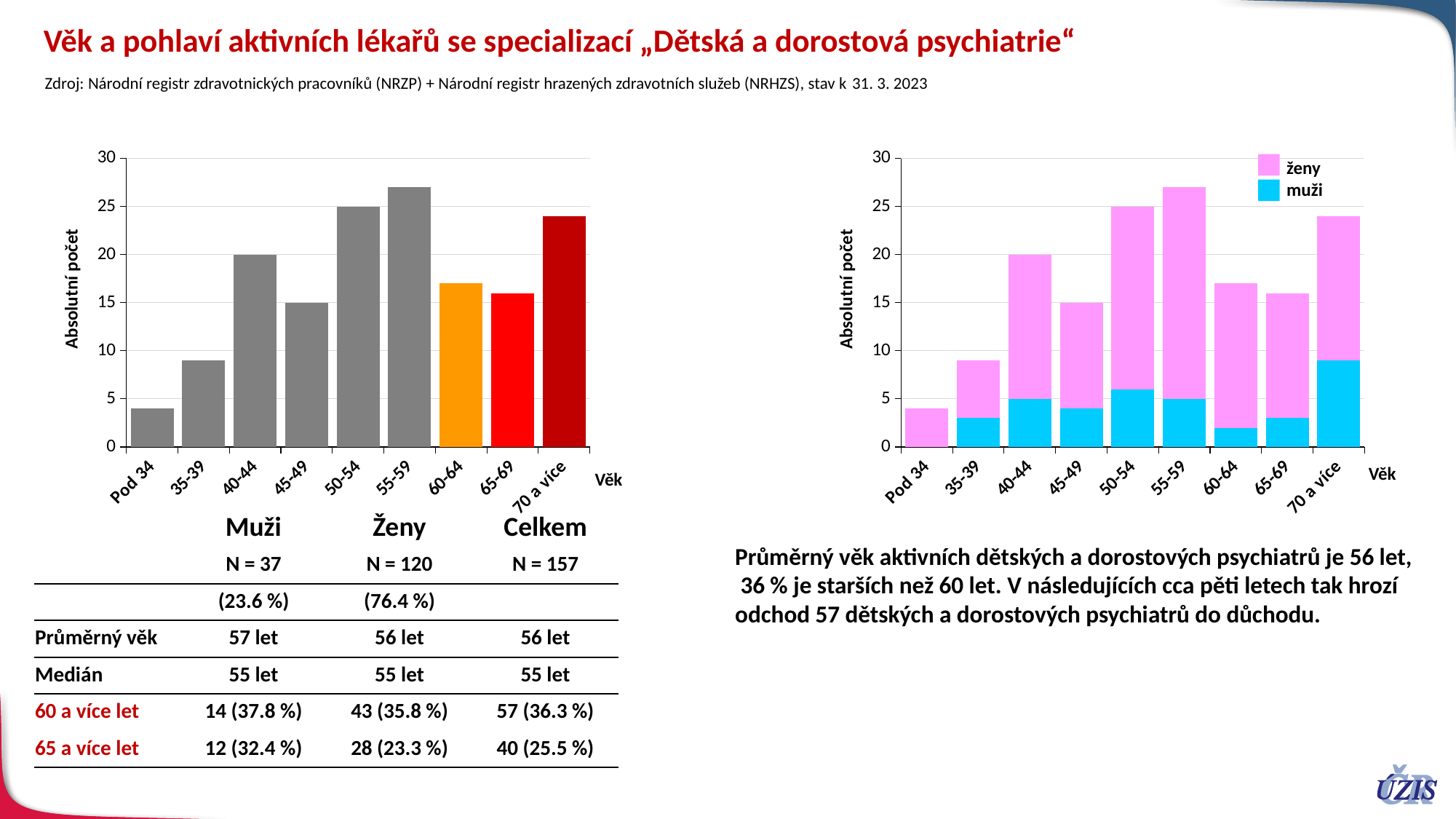
What are the two legend entries in the right chart? ženy, muži In the left chart, what is the absolute count for the 50-54 age group? 25 In the left chart, which age group has a larger value, 40-44 or 45-49? 40-44 In the left chart, is the value for the 55-59 age group greater or less than 25? greater In the right chart, is the muži value for the 70 a více age group greater or less than 5? greater How many series does the legend of the right chart list? 2 In the left chart, which age group has the lowest absolute count? Pod 34 How many age categories are shown on the x axis of the left chart? 9 What kind of chart is the left chart on the slide? bar chart In the left chart, which age group has the highest absolute count? 55-59 In the left chart, is the value for the Pod 34 age group greater or less than 5? less In the left chart, what is the absolute count for the 40-44 age group? 20